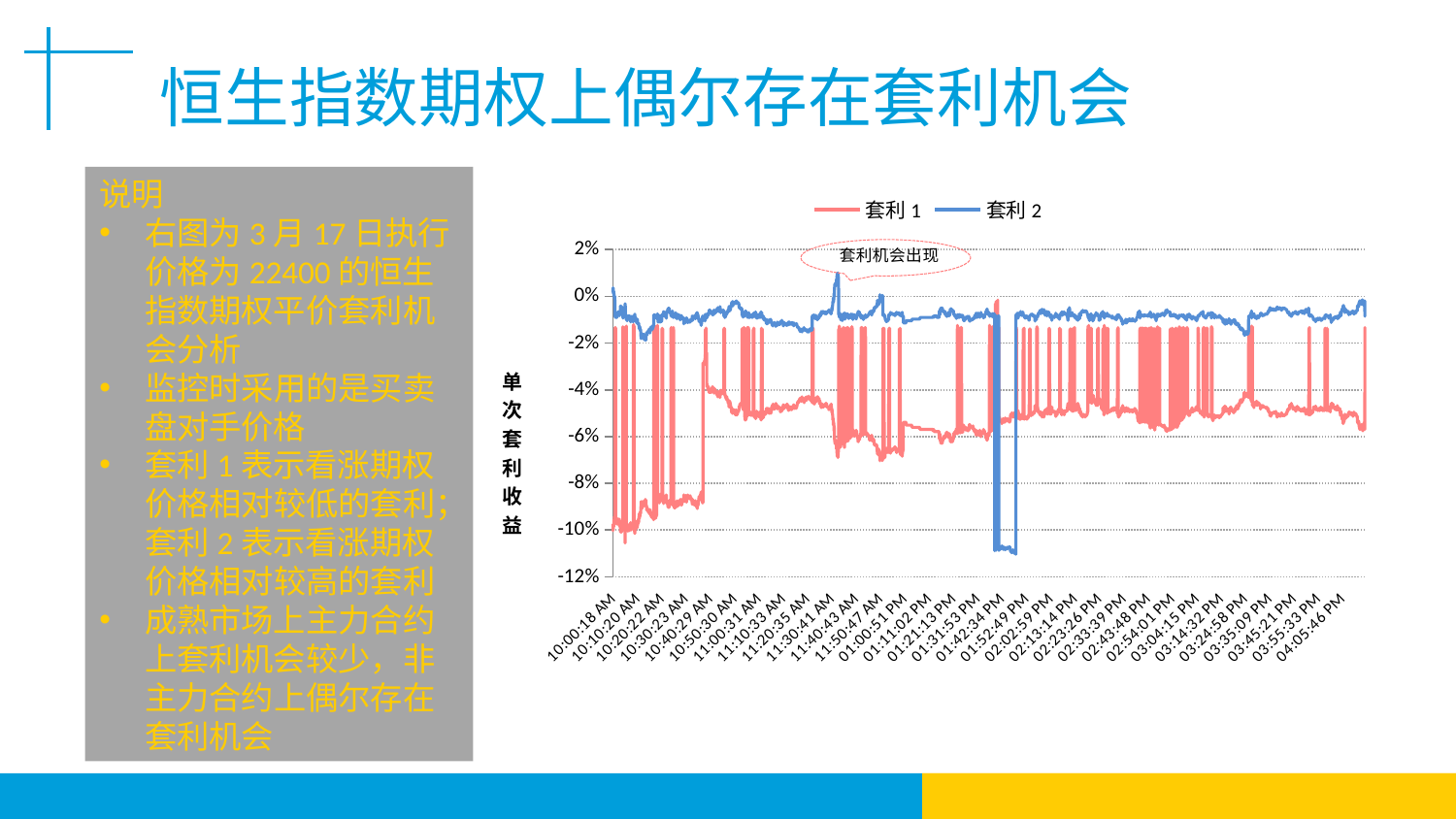
At 02:13:14 PM, which series has the higher value, 套利 1 or 套利 2? 套利 2 Is the value for 套利 1 at 01:00:51 PM greater or less than -4%? less What text is written in the callout annotation on the chart? 套利机会出现 What is the title of the chart's vertical axis? 单次套利收益 At 10:00:18 AM, which series has the higher value, 套利 1 or 套利 2? 套利 2 Is the value for 套利 2 at 11:00:31 AM greater or less than -4%? greater How many series does the chart's legend list? 2 Is the value for 套利 2 at 04:05:46 PM greater or less than -2%? greater What kind of chart is shown on the slide? line chart